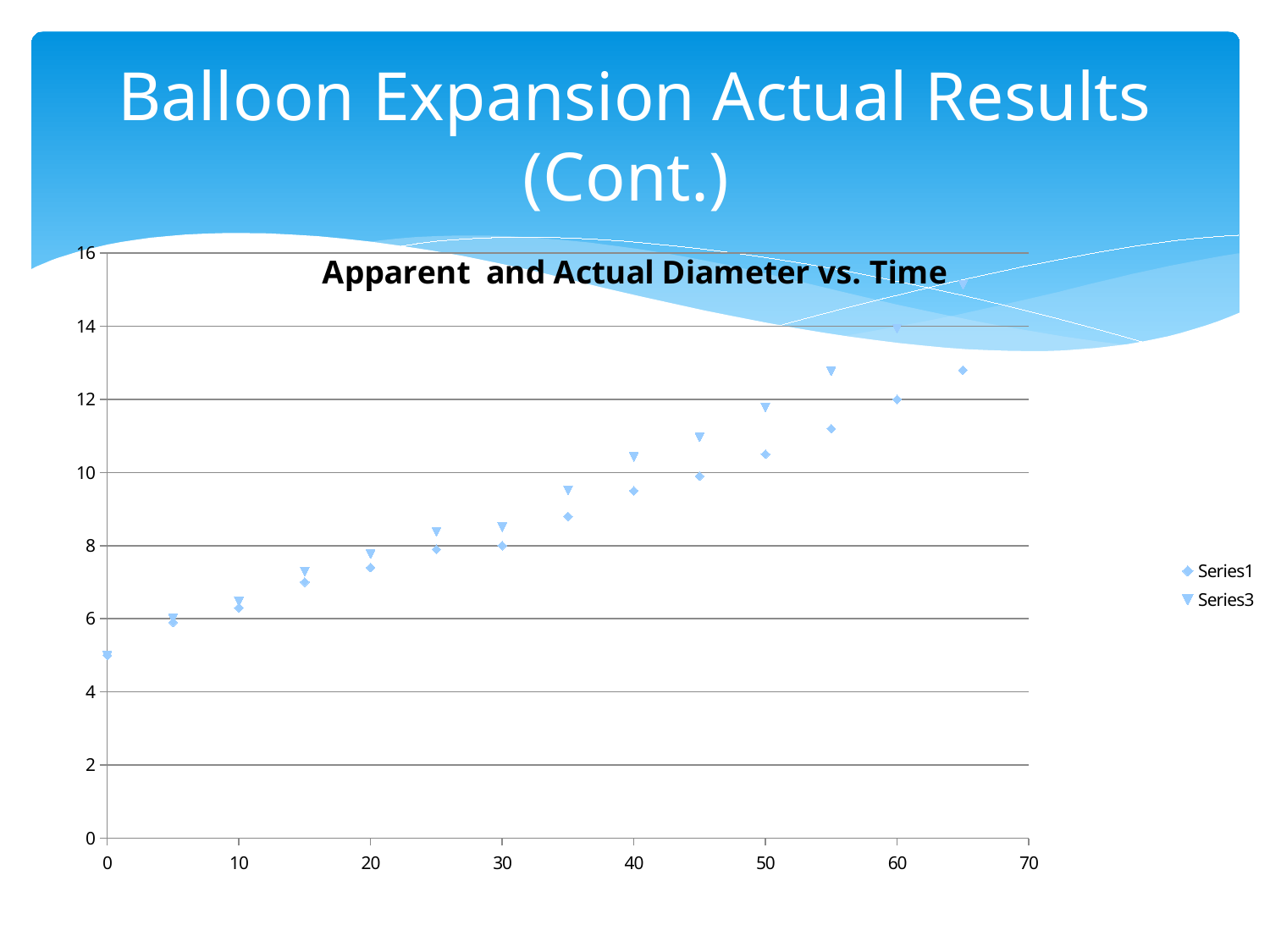
Is the Series3 value at time 65 greater or less than 14? greater How many data points are plotted for Series1? 14 Is the Series1 value at time 40 greater or less than 10? less At time 65, which series has the larger value, Series1 or Series3? Series3 Is the Series1 value at time 65 greater or less than 12? greater Do the Series3 values rise or fall as time increases along the x axis? rise What kind of chart is shown on the slide? scatter chart What are the names of the two series in the legend? Series1 and Series3 How many series does the chart legend list? 2 What is the title of the chart? Apparent and Actual Diameter vs. Time At which time value is Series1 at its highest? 65 Do the Series1 values rise or fall as time increases along the x axis? rise